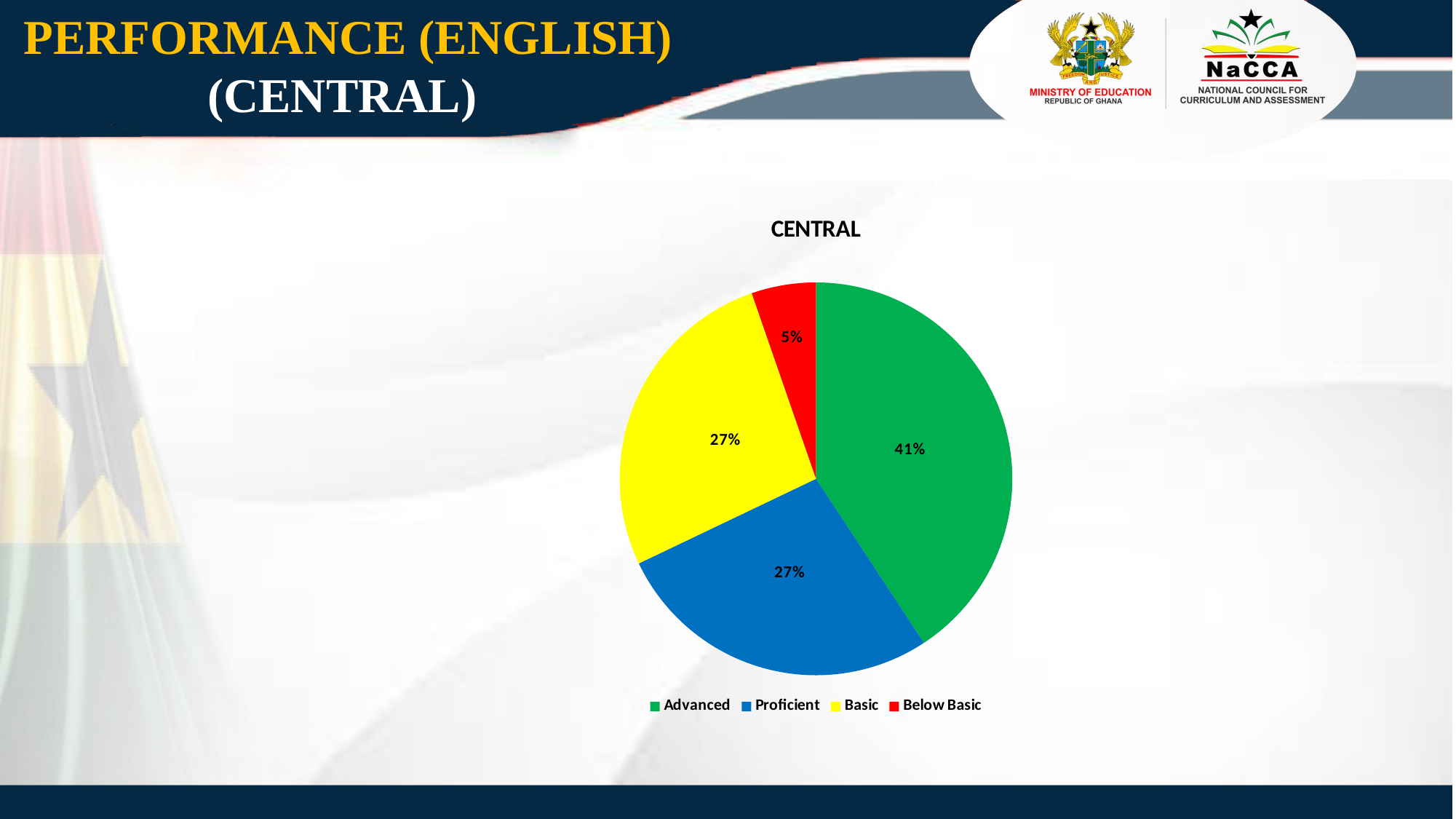
What percentage of the pie is Below Basic? 5% How many categories does the legend list? 4 What percentage of the pie is Basic? 27% What type of chart is shown on the slide? pie chart What percentage of the pie is Proficient? 27% Which category has the largest share of the pie? Advanced What colour represents Below Basic in the chart? red Which category has the smallest share of the pie? Below Basic What is the title of the chart? CENTRAL What percentage of the pie is Advanced? 41% Which is larger, the Advanced share or the Proficient share? Advanced What is the difference in percentage points between Advanced and Below Basic? 36